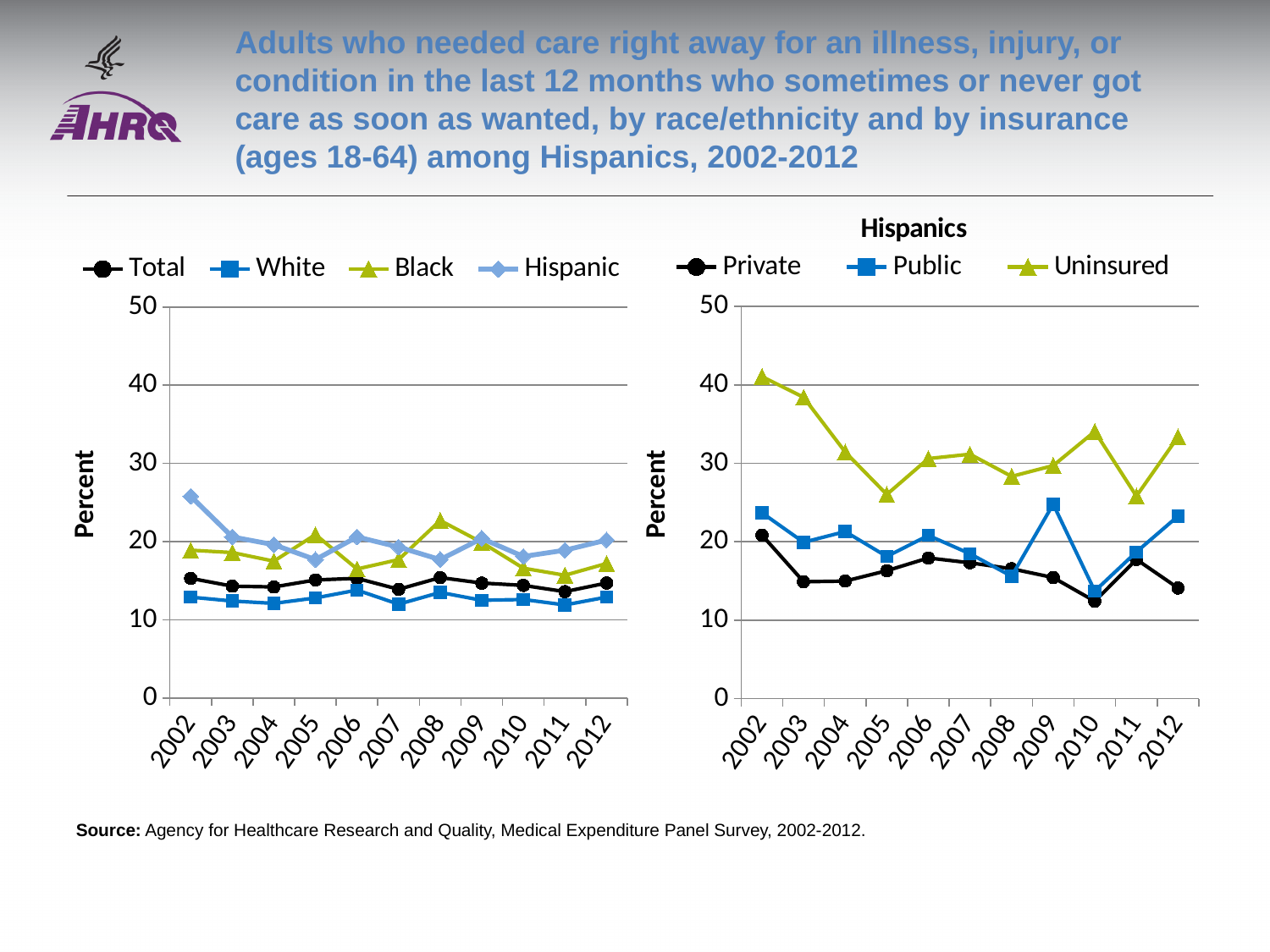
In the left chart (by race/ethnicity), is the value for Hispanic in 2002 greater or less than 20? greater In the right chart titled 'Hispanics', does the Uninsured line rise or fall from 2002 to 2005? Fall In the right chart titled 'Hispanics', which series has the highest value in 2002? Uninsured How many series does the legend of the right chart titled 'Hispanics' list? 3 How many series does the legend of the left chart (by race/ethnicity) list? 4 In the left chart (by race/ethnicity), which series has the lowest value in 2002? White In the right chart titled 'Hispanics', is the value for Uninsured in 2005 greater or less than 30? less What kind of chart is the left chart (by race/ethnicity)? Line chart In the right chart titled 'Hispanics', which is larger in 2009, Public or Private? Public In the left chart (by race/ethnicity), which series has the highest value in 2002? Hispanic In the right chart titled 'Hispanics', is the value for Uninsured in 2002 greater or less than 40? greater How many years are shown on the x axis of the right chart titled 'Hispanics'? 11